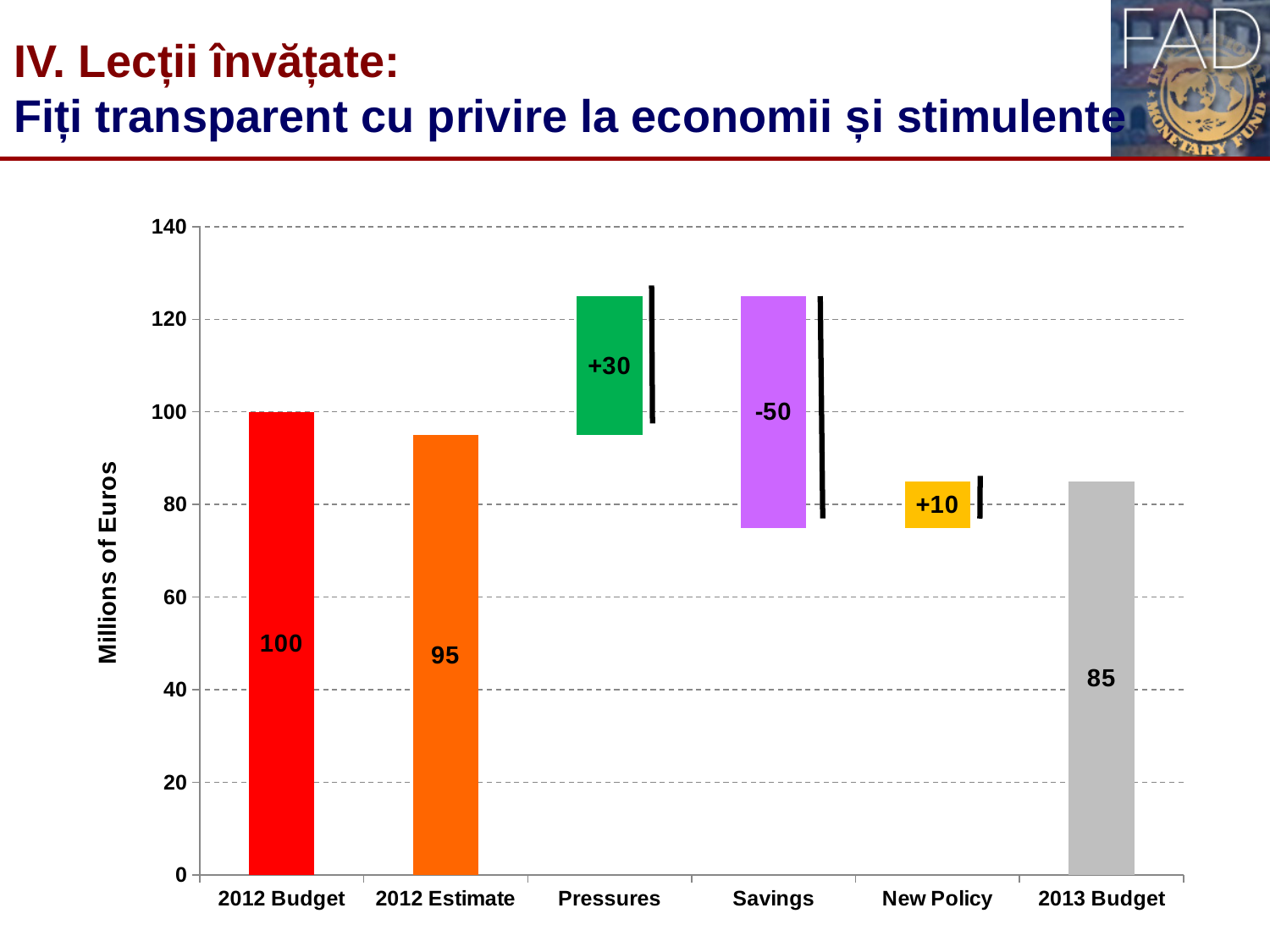
What is the value for 2012 Estimate? 95 Is the value for 2013 Budget greater or less than 80? greater What is the value for 2012 Budget? 100 What kind of chart is shown on the slide? bar chart How many categories are shown on the x axis? 6 What is the value labelled on the Savings bar? -50 What is the value labelled on the New Policy bar? +10 What is the difference between the 2012 Budget value and the 2013 Budget value? 15 What is the label of the vertical axis? Millions of Euros What is the value labelled on the Pressures bar? +30 What is the value for 2013 Budget? 85 Which is larger, the 2012 Budget value or the 2012 Estimate value? 2012 Budget